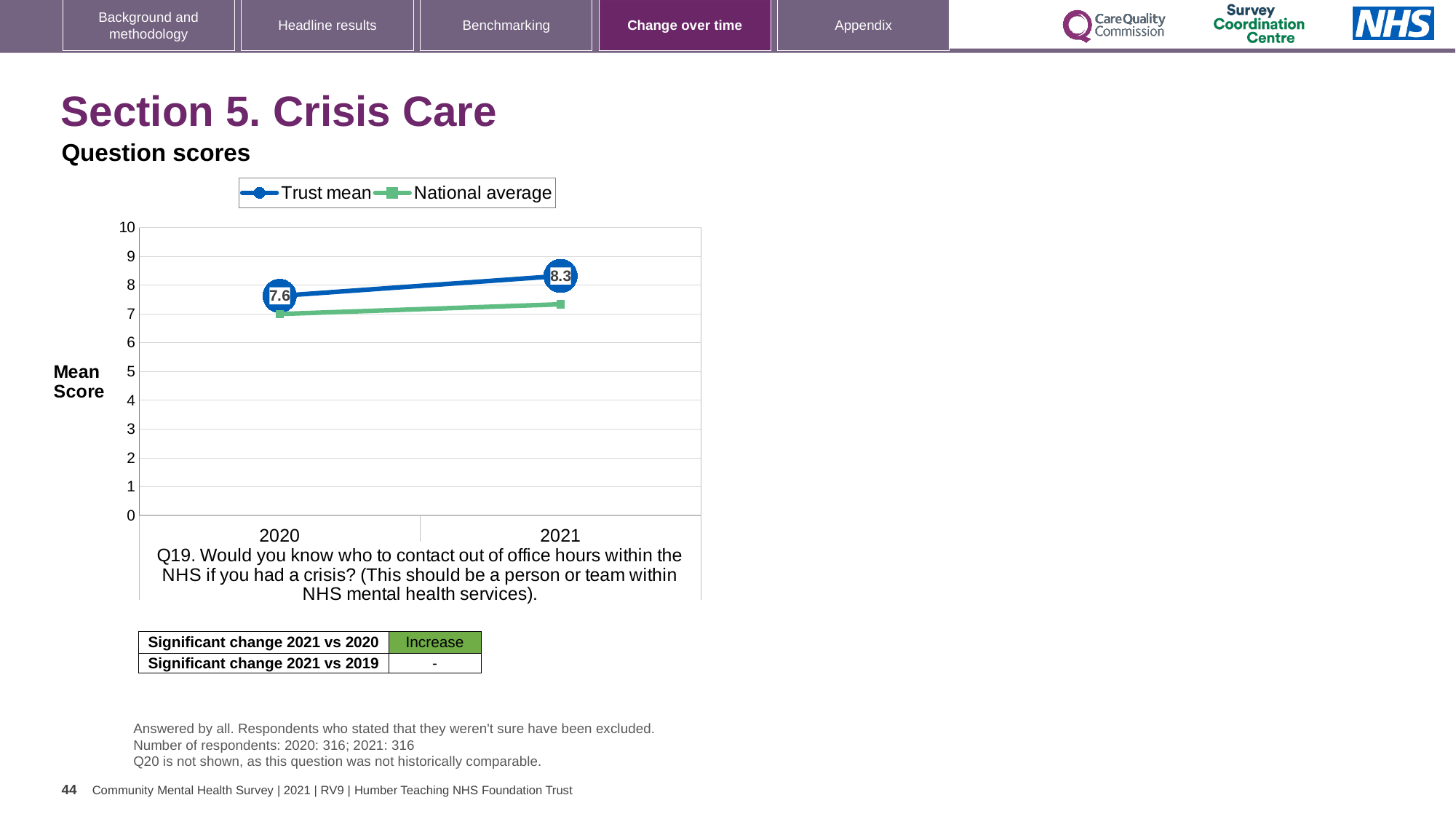
How many series does the chart legend list? 2 By how much did the Trust mean score change from 2020 to 2021? 0.7 What is the Trust mean score for 2021? 8.3 In 2021, which series has the higher value, Trust mean or National average? Trust mean What kind of chart is shown on the slide? line chart Does the Trust mean score rise or fall from 2020 to 2021? rise Which year has the higher Trust mean score, 2020 or 2021? 2021 In which year is the Trust mean score highest? 2021 What is the Trust mean score for 2020? 7.6 What is the label on the y axis of the chart? Mean Score Is the National average value for 2021 greater or less than 8? less How many years are plotted on the x axis of the chart? 2